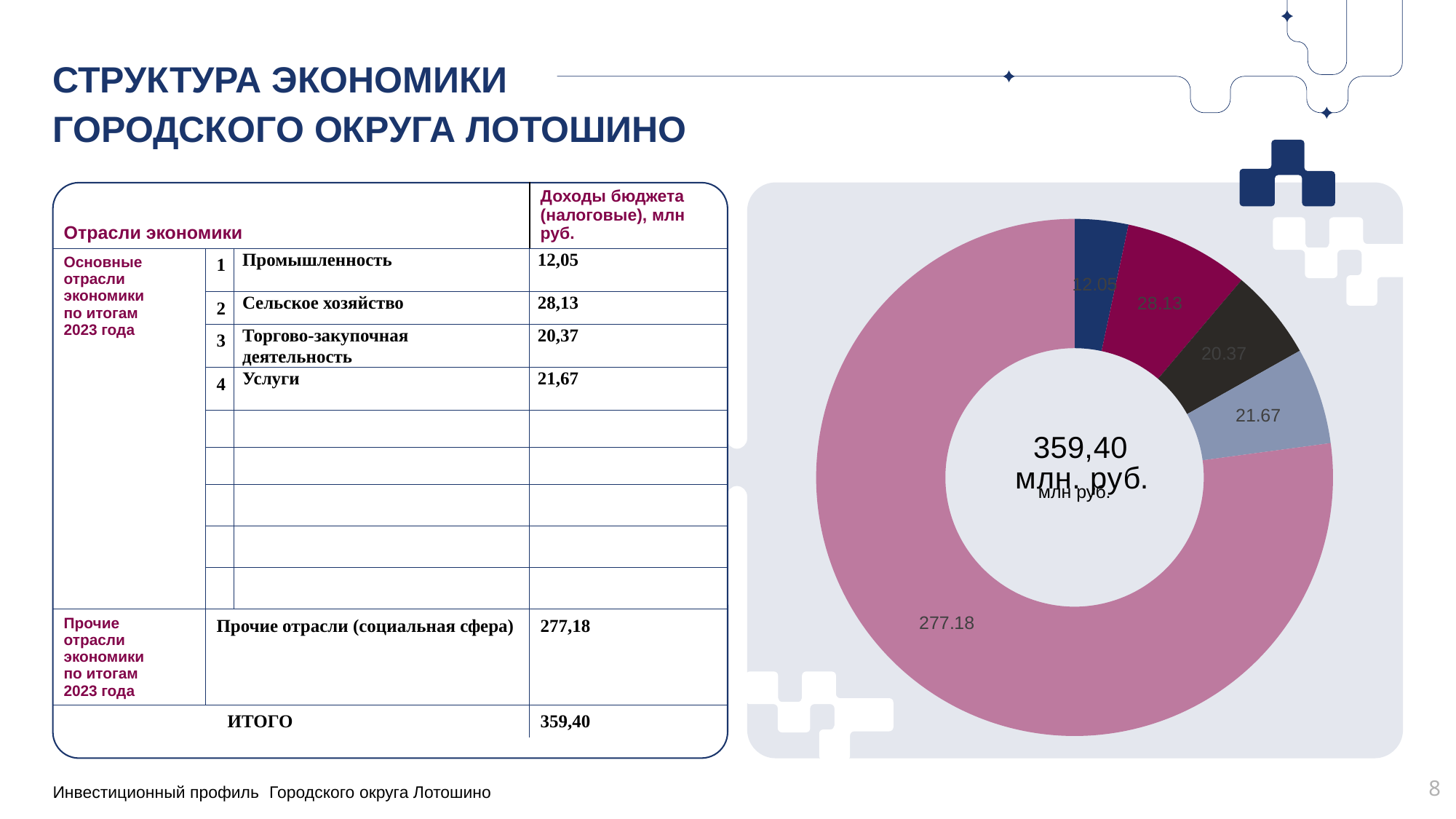
What value is shown on the doughnut chart for Услуги? 21.67 How many slices does the doughnut chart have? 5 What value is shown on the doughnut chart for Сельское хозяйство? 28.13 What value is printed on the largest slice of the doughnut chart? 277.18 What value is printed on the smallest slice of the doughnut chart? 12.05 What is the difference between the slice values 28.13 and 20.37 on the doughnut chart? 7.76 What total is printed in the centre of the doughnut chart? 359,40 млн. руб. What colour is the largest slice of the doughnut chart? pink What kind of chart is shown on the right side of the slide? doughnut chart Which slice is larger on the doughnut chart: Услуги or Торгово-закупочная деятельность? Услуги Which sector has the largest slice in the doughnut chart? Прочие отрасли (социальная сфера) Which sector has the smallest slice in the doughnut chart? Промышленность